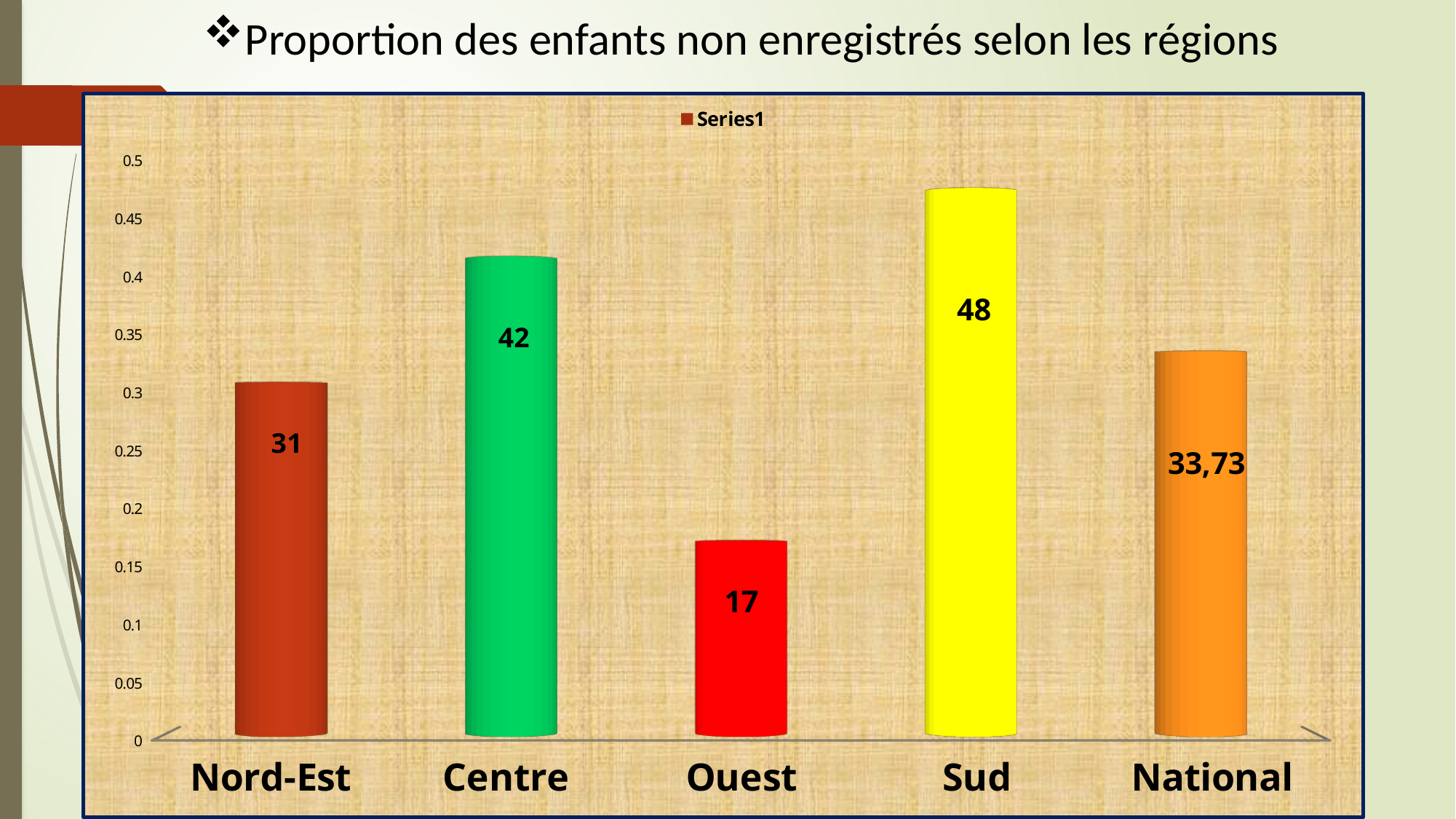
What is the value shown for Ouest? 17 What is the value shown for Centre? 42 What kind of chart is shown on the slide? bar chart What is the difference between the values for Sud and Ouest? 31 What is the value shown for National? 33,73 Which category has the lowest value? Ouest Which is larger, the value for Nord-Est or the value for National? National Is the bar for Ouest greater or less than 0.2 on the axis? less How many series does the legend list? 1 What is the difference between the values for Centre and Nord-Est? 11 Which region has the highest value? Sud How many categories are shown on the x axis? 5